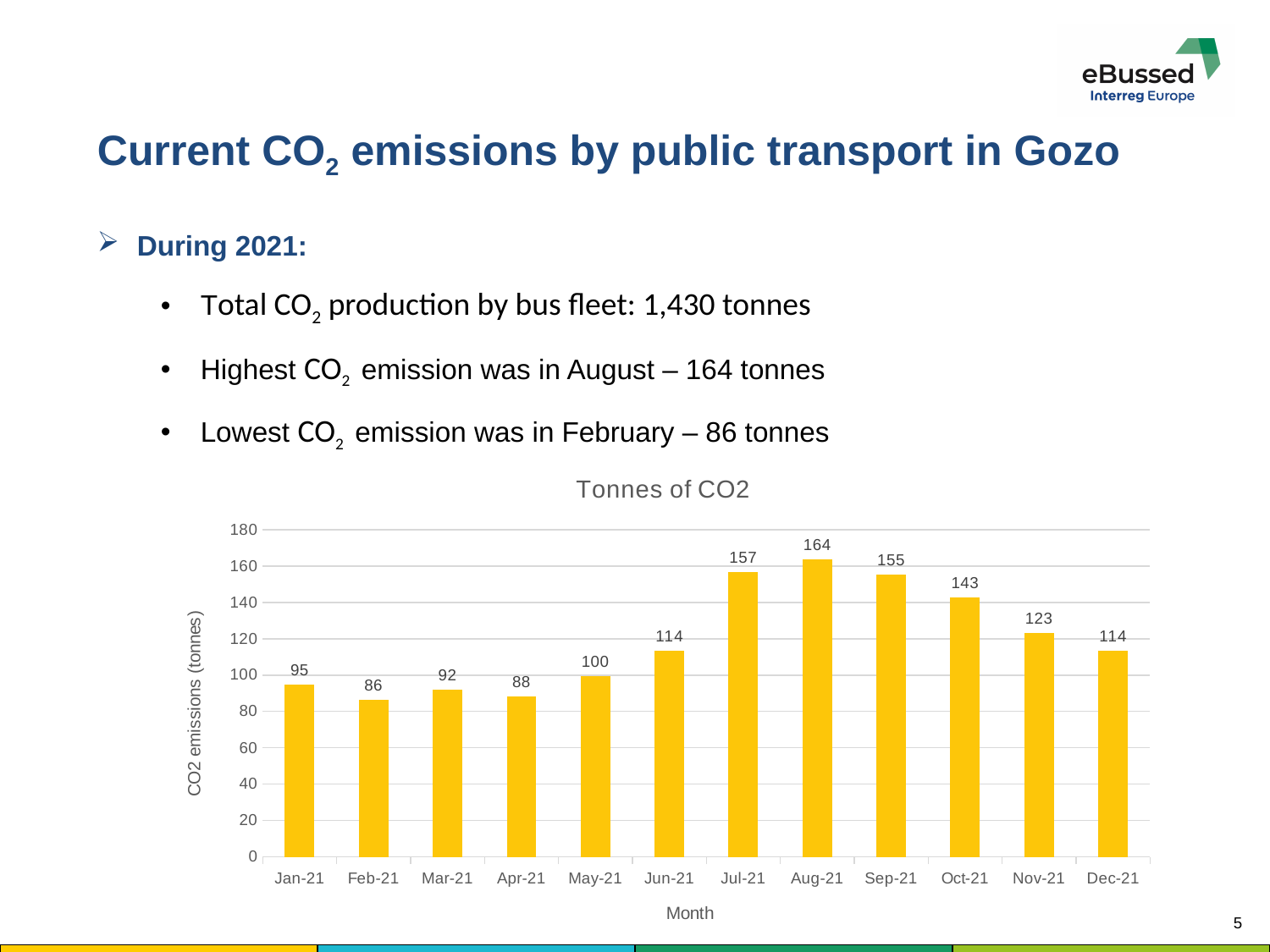
What is the value for Oct-21 in the Tonnes of CO2 chart? 143 Is the value for Nov-21 in the Tonnes of CO2 chart greater or less than 120? greater How many months are shown on the x axis of the Tonnes of CO2 chart? 12 What is the title of the chart on the slide? Tonnes of CO2 Which month has the highest value in the Tonnes of CO2 chart? Aug-21 Which is larger in the Tonnes of CO2 chart, the value for Jul-21 or the value for Sep-21? Jul-21 Which month has the lowest value in the Tonnes of CO2 chart? Feb-21 What is the difference between the values for Aug-21 and Feb-21 in the Tonnes of CO2 chart? 78 What is the value for Aug-21 in the Tonnes of CO2 chart? 164 What is the label of the y axis in the Tonnes of CO2 chart? CO2 emissions (tonnes) What is the value for Feb-21 in the Tonnes of CO2 chart? 86 What kind of chart is the Tonnes of CO2 chart? bar chart